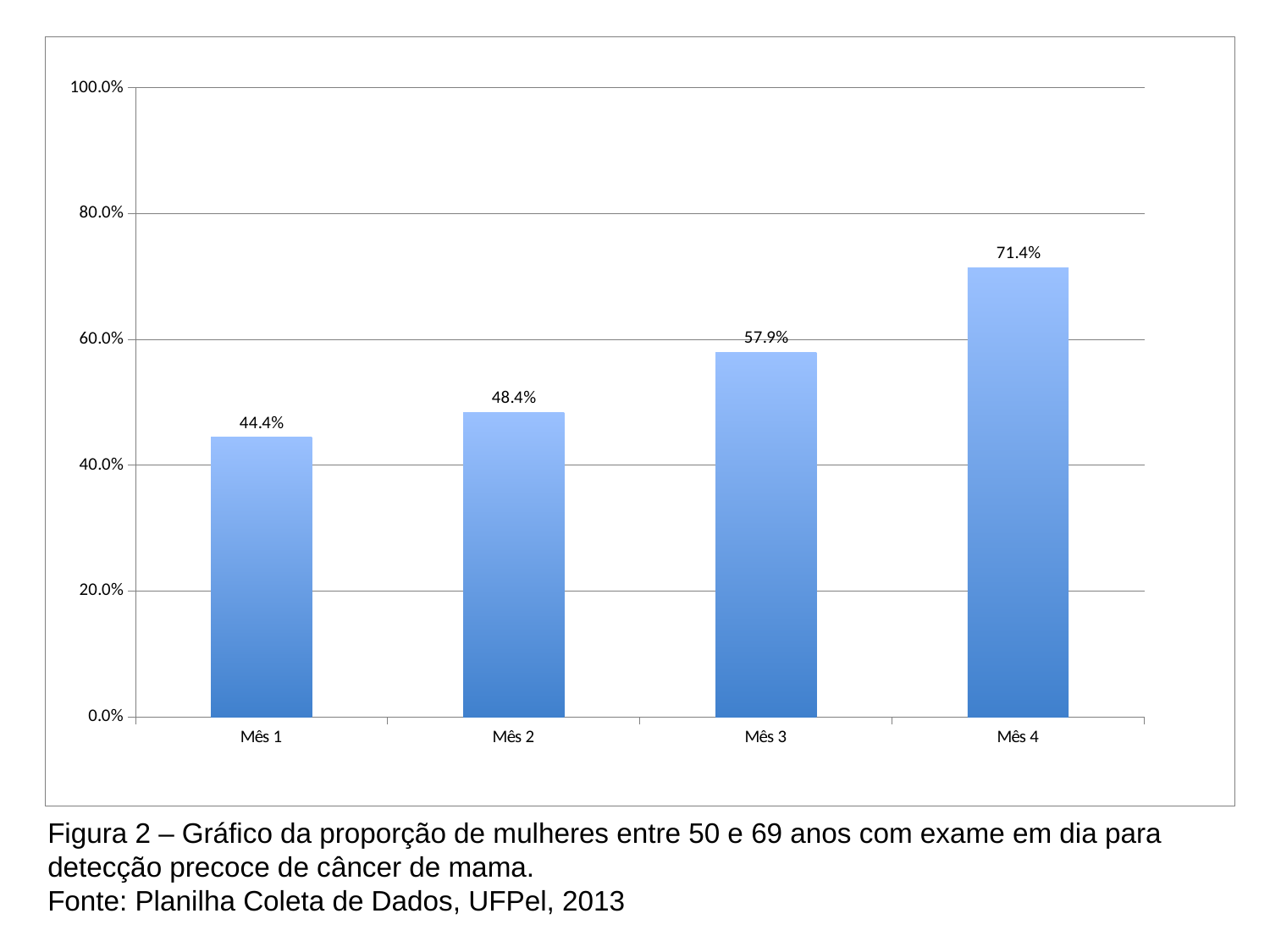
How many months are shown on the x axis? 4 Do the values rise or fall from Mês 1 to Mês 4? Rise What is the value for Mês 4? 71.4% What is the value for Mês 1? 44.4% Which month has the lowest value? Mês 1 What kind of chart is shown on the slide? Bar chart Is the value for Mês 4 greater or less than 60.0%? greater Which month has the highest value? Mês 4 What is the difference between the values for Mês 3 and Mês 2? 9.5% Which is larger, the value for Mês 2 or the value for Mês 3? Mês 3 What is the value for Mês 3? 57.9% What is the difference between the values for Mês 4 and Mês 1? 27.0%